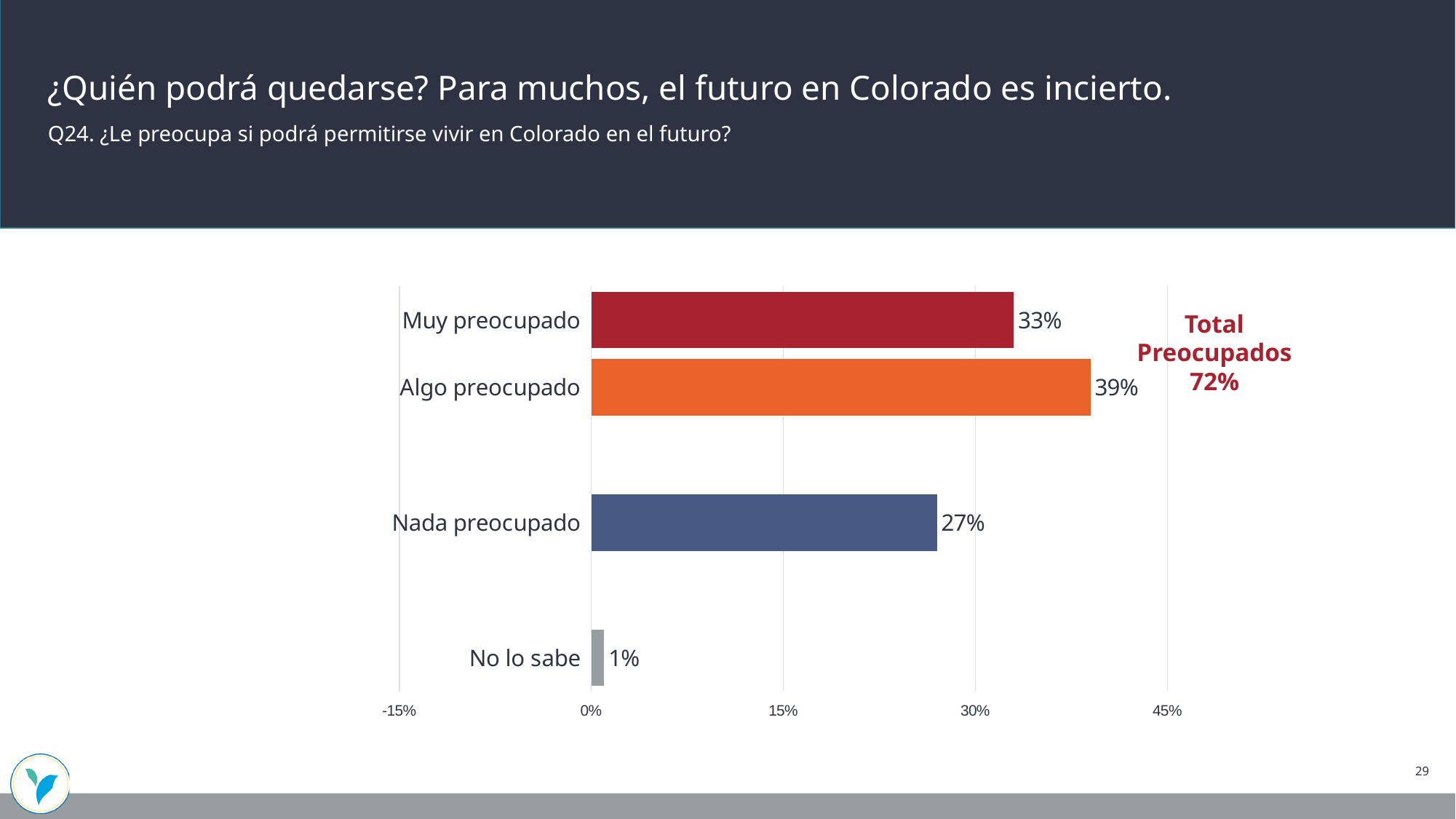
What is the difference between Algo preocupado and Muy preocupado? 6% Which is larger, Muy preocupado or Nada preocupado? Muy preocupado What is the value for Muy preocupado? 33% What kind of chart is shown on the slide? bar chart How many categories are shown in the chart? 4 Is the value for Nada preocupado greater or less than 30%? less What is the Total Preocupados figure shown next to the chart? 72% Which category has the highest value? Algo preocupado What is the value for No lo sabe? 1% What is the value for Algo preocupado? 39% What is the value for Nada preocupado? 27% Which category has the lowest value? No lo sabe